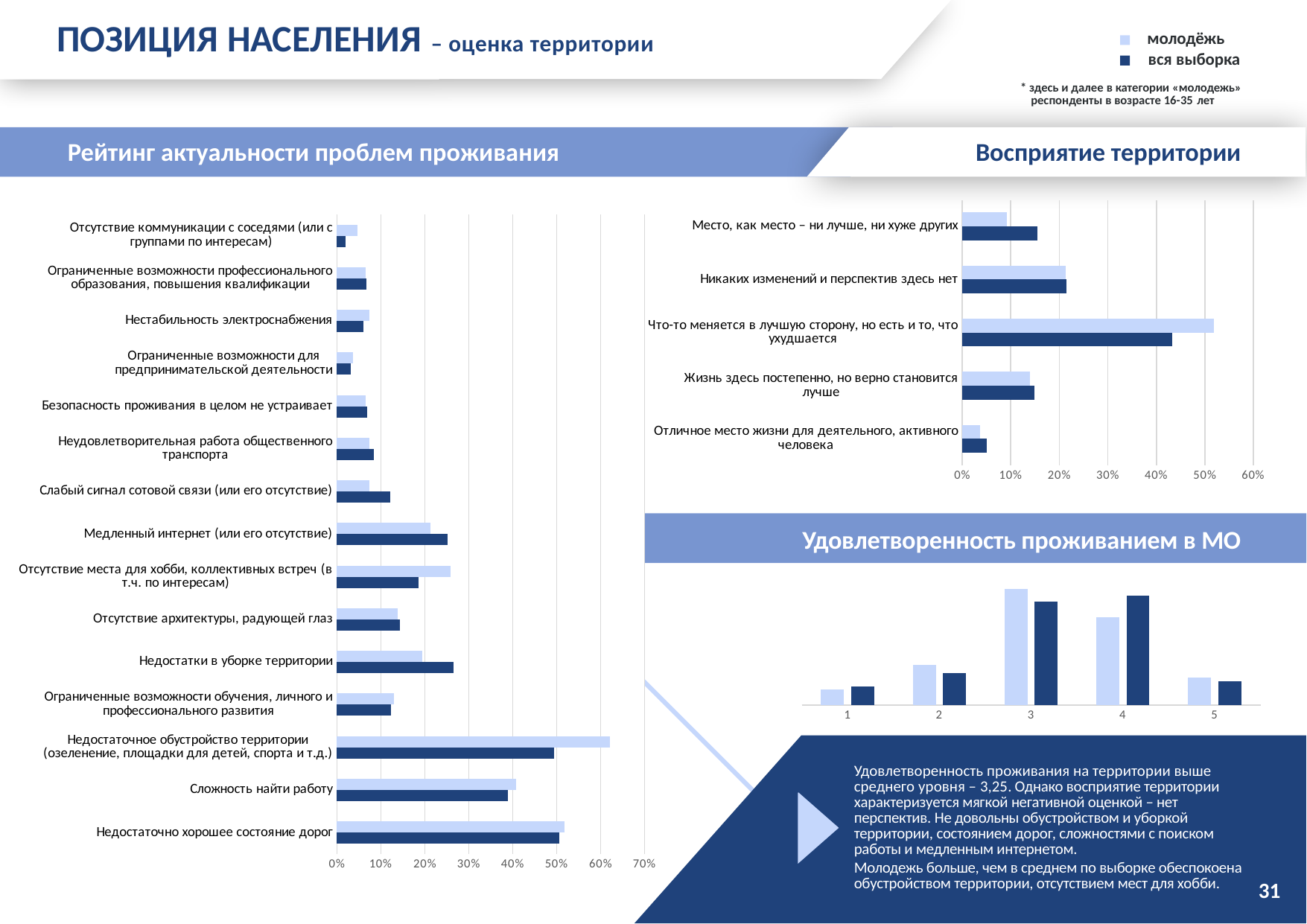
On the chart 'Восприятие территории', which category has the highest value for вся выборка? Что-то меняется в лучшую сторону, но есть и то, что ухудшается On the chart 'Рейтинг актуальности проблем проживания', which category has the highest value for молодёжь? Недостаточное обустройство территории (озеленение, площадки для детей, спорта и т.д.) On the chart 'Восприятие территории', which category has the lowest value for молодёжь? Отличное место жизни для деятельного, активного человека On the chart 'Рейтинг актуальности проблем проживания', for 'Отсутствие места для хобби, коллективных встреч', which series has the larger value: молодёжь or вся выборка? молодёжь On the chart 'Восприятие территории', is the молодёжь value for 'Что-то меняется в лучшую сторону, но есть и то, что ухудшается' greater or less than 40%? greater On the chart 'Рейтинг актуальности проблем проживания', which category has the lowest value for вся выборка? Отсутствие коммуникации с соседями (или с группами по интересам) On the chart 'Удовлетворенность проживанием в МО', which rating has the highest bar for вся выборка? 4 On the chart 'Рейтинг актуальности проблем проживания', for 'Слабый сигнал сотовой связи (или его отсутствие)', which series has the larger value: молодёжь or вся выборка? вся выборка On the chart 'Рейтинг актуальности проблем проживания', is the молодёжь value for 'Недостаточное обустройство территории' greater or less than 50%? greater How many series does the legend at the top of the slide list? 2 On the chart 'Рейтинг актуальности проблем проживания', how many problem categories are listed? 15 On the chart 'Рейтинг актуальности проблем проживания', is the вся выборка value for 'Медленный интернет (или его отсутствие)' greater or less than 20%? greater